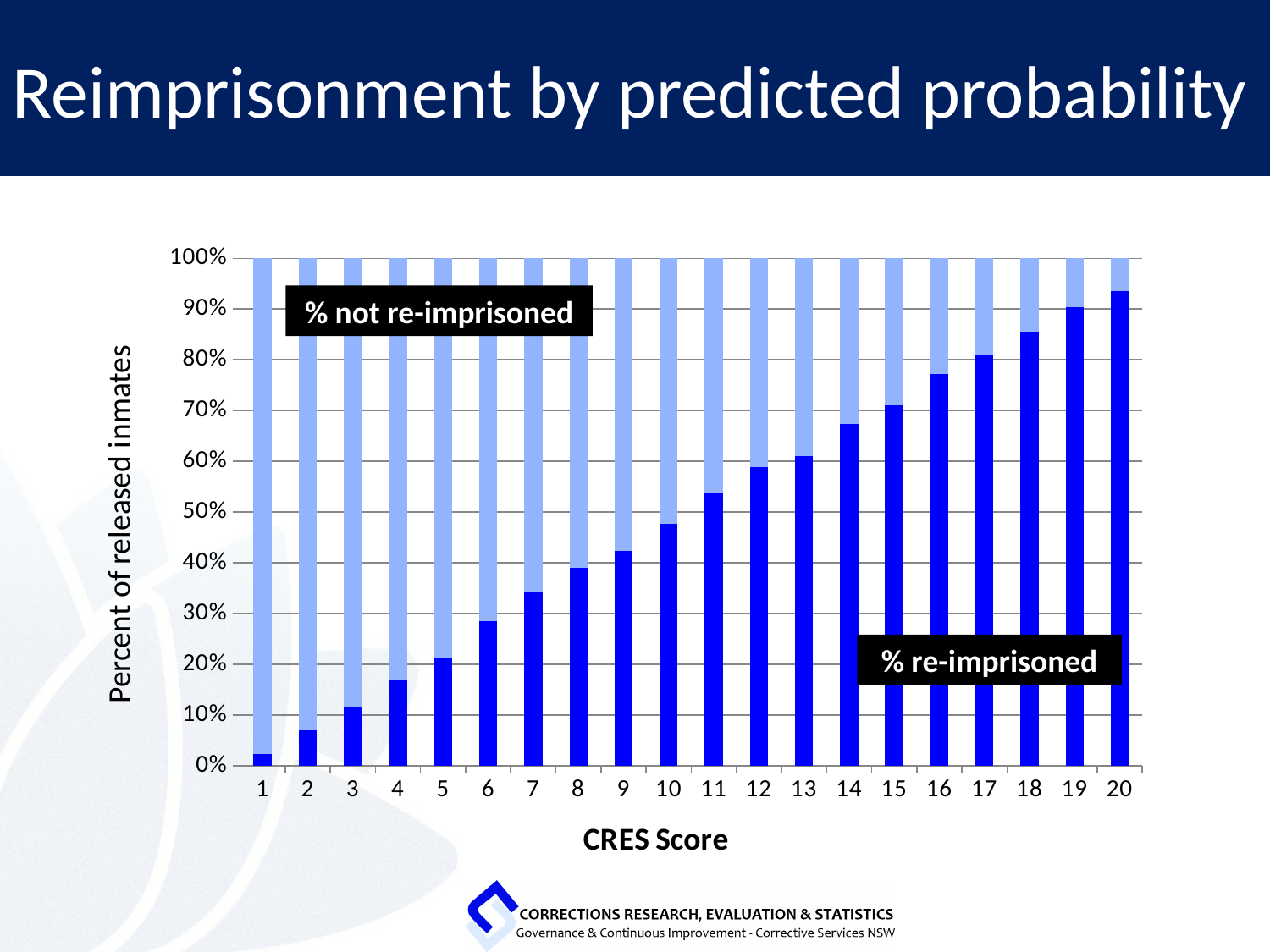
What is the title of the x axis? CRES Score Which CRES Score has the highest % re-imprisoned? 20 Is the % re-imprisoned for CRES Score 7 greater or less than 30%? greater What is the total height of each stacked bar in the chart? 100% How many series are shown in the chart? 2 Which CRES Score has the lowest % re-imprisoned? 1 Which has a larger % re-imprisoned, CRES Score 4 or CRES Score 14? CRES Score 14 Does the % re-imprisoned value rise or fall as the CRES Score increases from 1 to 20? Rise Is the % re-imprisoned for CRES Score 10 greater or less than 50%? less What kind of chart is shown on the slide? Stacked bar chart Is the % re-imprisoned for CRES Score 16 greater or less than 70%? greater How many CRES Score categories are plotted along the x axis? 20